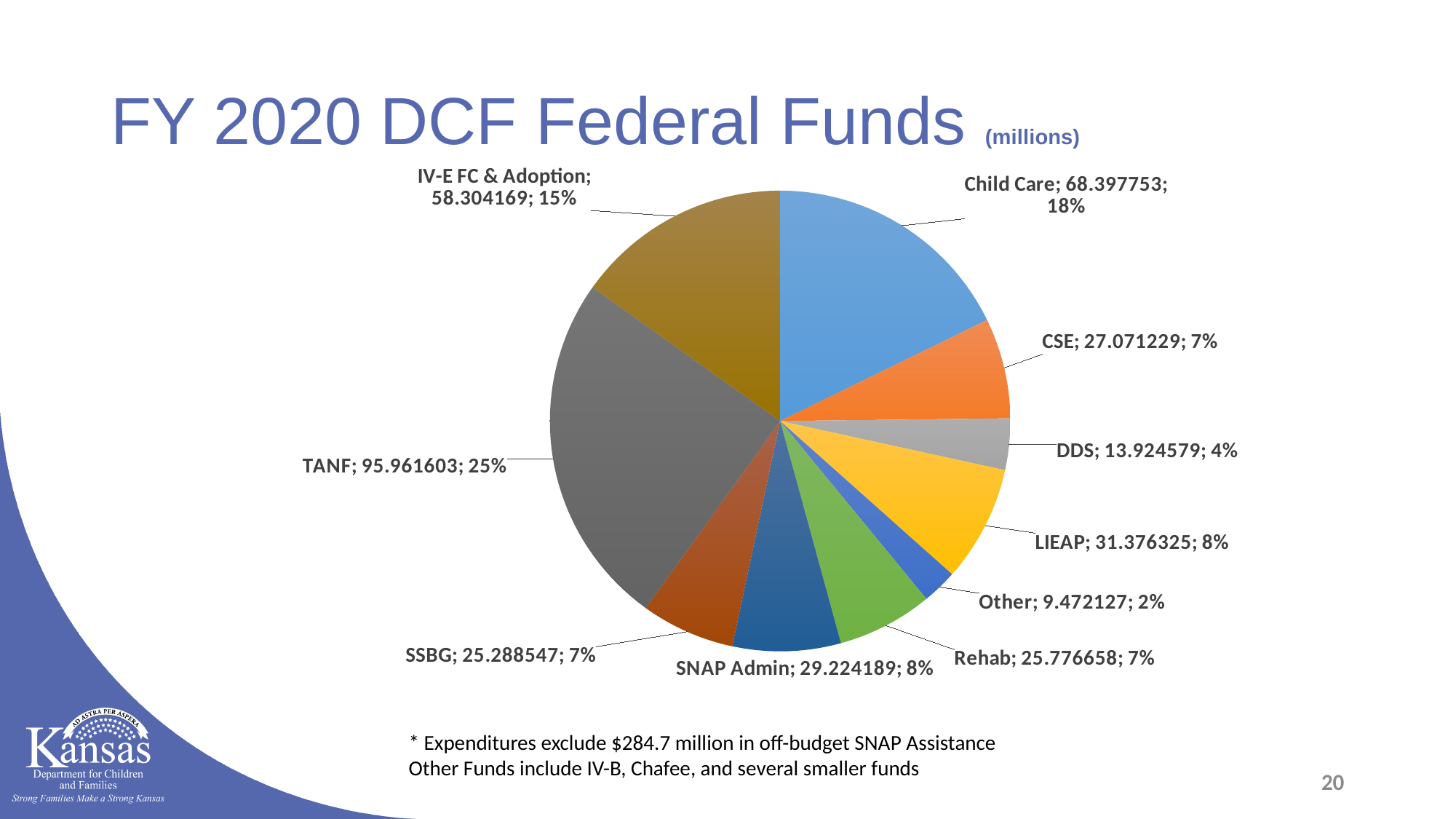
Which category has the smallest slice? Other What is the title of the chart? FY 2020 DCF Federal Funds (millions) What is the value for LIEAP? 31.376325 What share of the pie does IV-E FC & Adoption represent? 15% What is the difference between the Child Care value and the IV-E FC & Adoption value? 10.093584 Which is larger, the value for CSE or the value for SSBG? CSE How many categories are shown in the pie chart? 10 What is the difference between the TANF value and the Child Care value? 27.56385 Which category has the largest slice? TANF What kind of chart is shown on the slide? Pie chart What share of the pie does Child Care represent? 18% What is the value for TANF? 95.961603